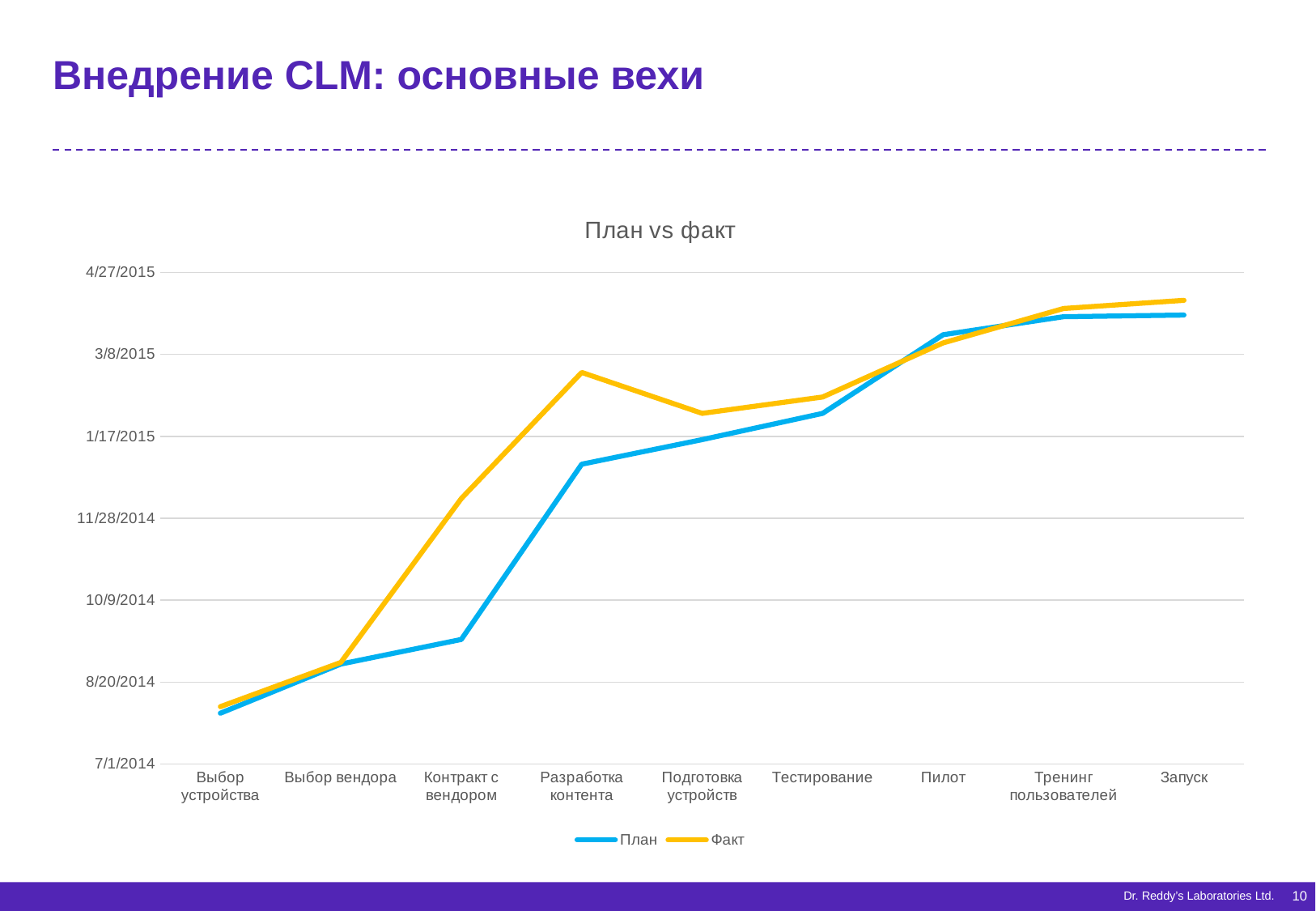
What kind of chart is shown on the slide? line chart Is the План value for Разработка контента earlier or later than 1/17/2015? earlier Is the План value for Контракт с вендором earlier or later than 10/9/2014? earlier Is the Факт value for Разработка контента earlier or later than 1/17/2015? later Which milestone has the earliest date for the План series? Выбор устройства Do the План values rise or fall from Выбор устройства to Запуск? rise How many milestone categories are shown on the x axis? 9 At Разработка контента, which series has the later date, План or Факт? Факт How many series does the legend list? 2 What is the title of the chart? План vs факт Which series is drawn in yellow? Факт